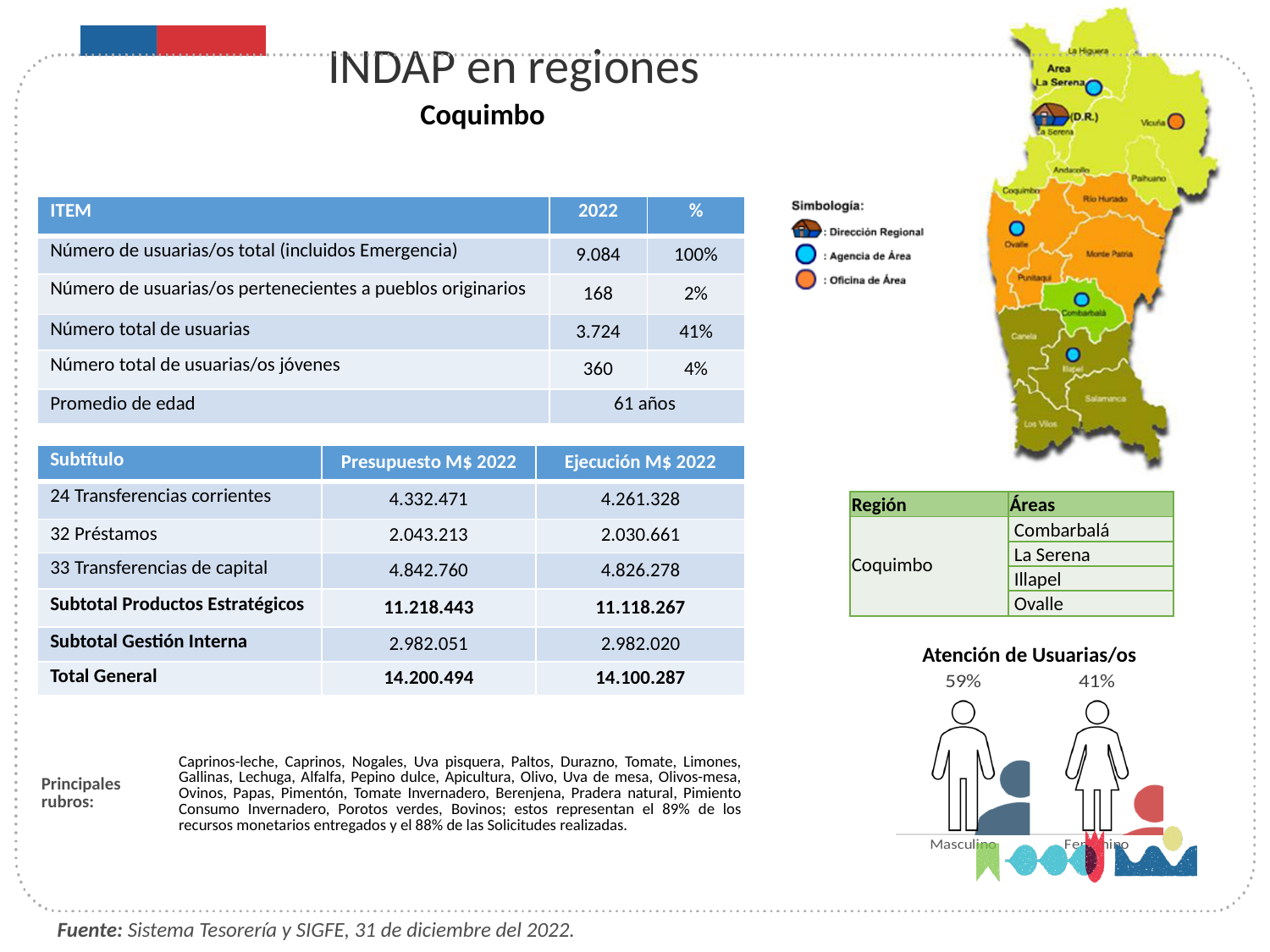
In the 'Atención de Usuarias/os' chart, which category has the highest value? Masculino In the 'Atención de Usuarias/os' chart, is the value for Masculino greater or less than 50%? greater In the 'Atención de Usuarias/os' chart, which is larger, Masculino or Femenino? Masculino In the 'Atención de Usuarias/os' chart, which category has the lowest value? Femenino What is the title of the chart in the lower right of the slide? Atención de Usuarias/os In the 'Atención de Usuarias/os' chart, is the value for Femenino greater or less than 50%? less In the 'Atención de Usuarias/os' chart, what is the value for Femenino? 41% In the 'Atención de Usuarias/os' chart, what do the Masculino and Femenino values add up to? 100% In the 'Atención de Usuarias/os' chart, what are the two category labels shown below the figures? Masculino and Femenino In the 'Atención de Usuarias/os' chart, what is the difference between the Masculino and Femenino values? 18% How many categories are shown in the 'Atención de Usuarias/os' chart? 2 In the 'Atención de Usuarias/os' chart, what is the value for Masculino? 59%